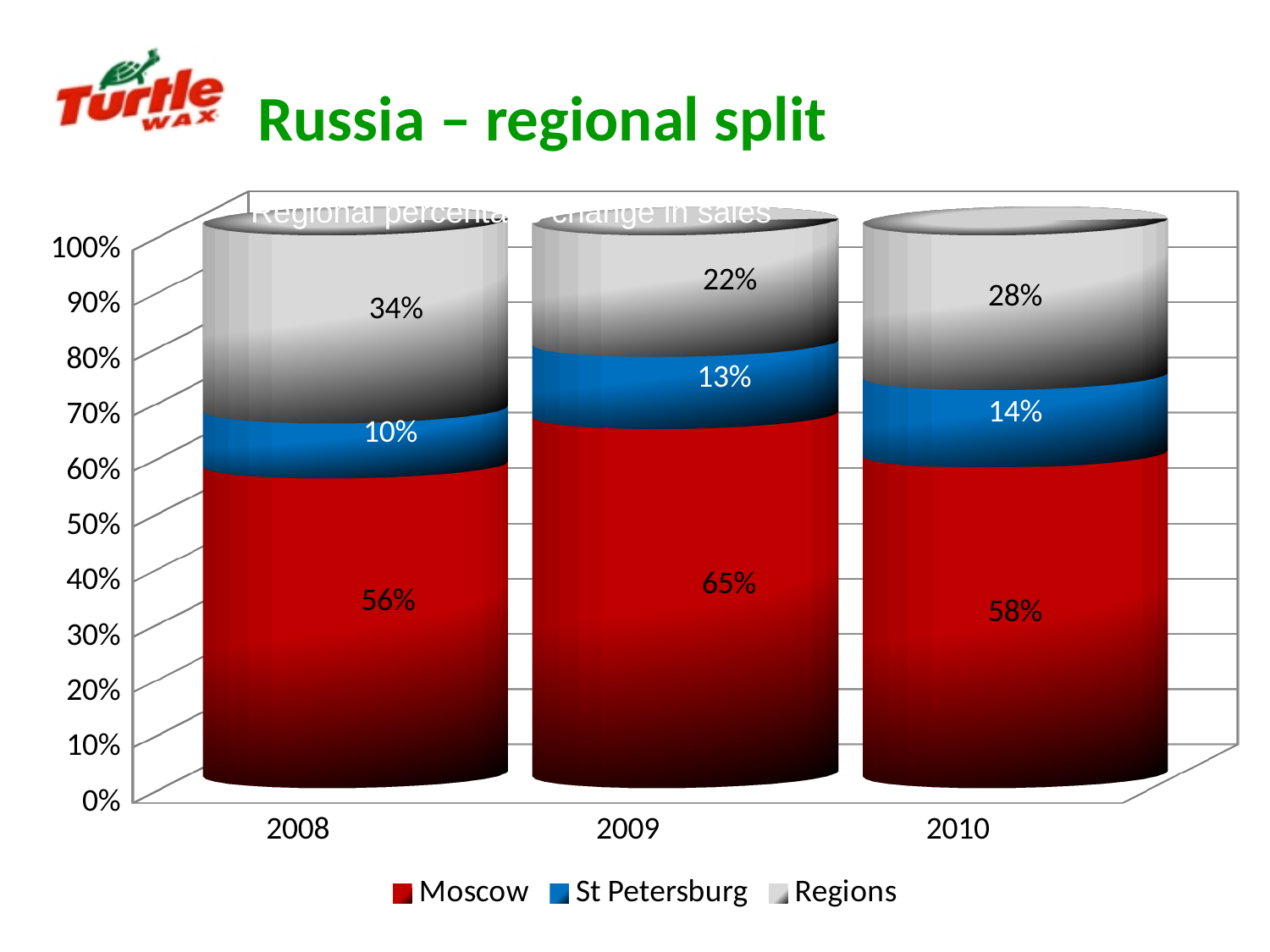
What kind of chart is shown on the slide? Stacked bar chart In which year was St Petersburg's share the lowest? 2008 How many years are shown on the x axis? 3 How many series does the legend list? 3 What is the difference between the Regions share in 2008 and in 2009? 12% What share did Regions account for in 2008? 34% Which colour represents Moscow in the chart? Red Does the St Petersburg share rise or fall from 2008 to 2010? Rise In which year was Moscow's share the highest? 2009 What share did St Petersburg account for in 2010? 14% Which was larger in 2010: the Moscow share or the Regions share? Moscow What share did Moscow account for in 2009? 65%